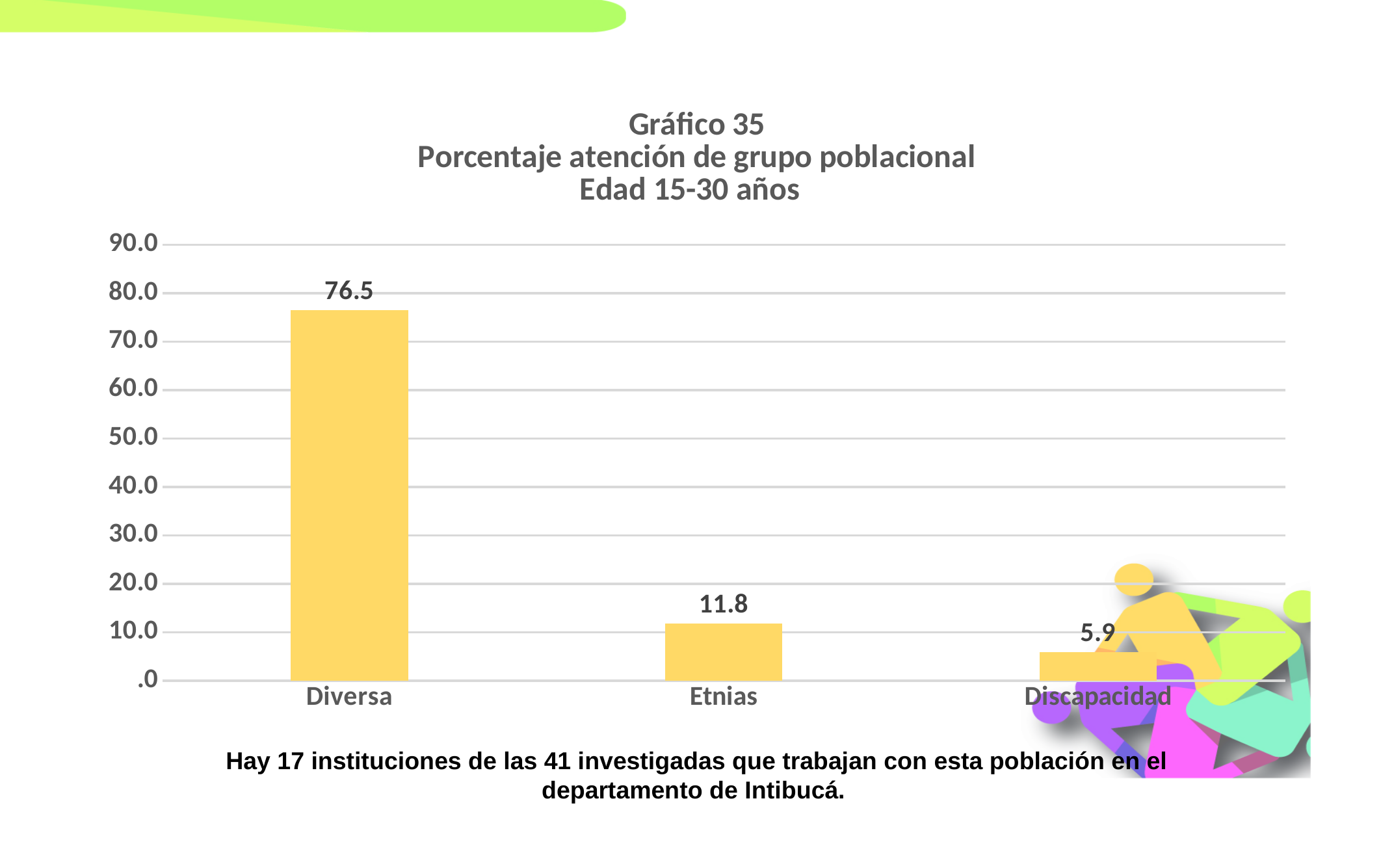
Which category has the lowest value? Discapacidad What is the value for Etnias? 11.8 What is the value for Discapacidad? 5.9 Which category has the highest value? Diversa What is the difference between the values for Diversa and Etnias? 64.7 What age range is given in the chart title? 15-30 años Which is larger, the value for Etnias or the value for Discapacidad? Etnias How many categories are shown on the x axis? 3 What is the difference between the values for Etnias and Discapacidad? 5.9 What kind of chart is shown on the slide? bar chart What is the value for Diversa? 76.5 Is the value for Diversa greater or less than 70.0? greater